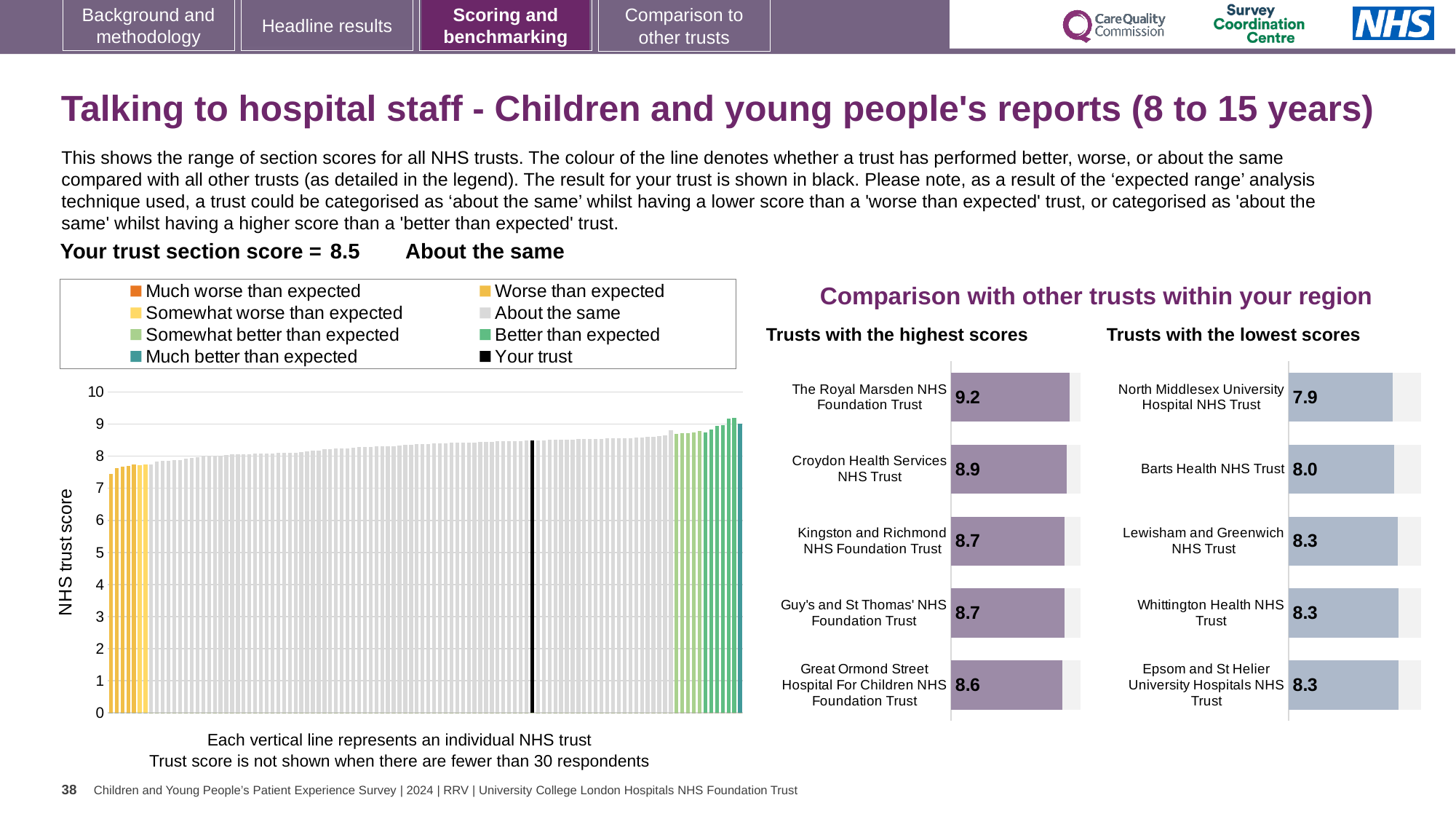
In the 'Trusts with the highest scores' chart, what is the score for The Royal Marsden NHS Foundation Trust? 9.2 In the large chart on the left, is the value of the tallest bar greater or less than 9? greater How many entries does the legend above the large chart on the left list? 8 In the large chart on the left, do the trust scores rise or fall from left to right? rise In the 'Trusts with the lowest scores' chart, which has the larger score: Barts Health NHS Trust or Lewisham and Greenwich NHS Trust? Lewisham and Greenwich NHS Trust In the 'Trusts with the highest scores' chart, which trust has the highest score? The Royal Marsden NHS Foundation Trust In the 'Trusts with the highest scores' chart, what is the difference between the scores of The Royal Marsden NHS Foundation Trust and Great Ormond Street Hospital For Children NHS Foundation Trust? 0.6 How many trusts are shown in the 'Trusts with the lowest scores' chart? 5 In the large chart on the left, is the value of the leftmost (lowest) bar greater or less than 8? less In the large chart on the left, what is the label on the vertical axis? NHS trust score What kind of chart is the large chart on the left showing NHS trust scores? bar chart In the 'Trusts with the lowest scores' chart, which trust has the lowest score? North Middlesex University Hospital NHS Trust